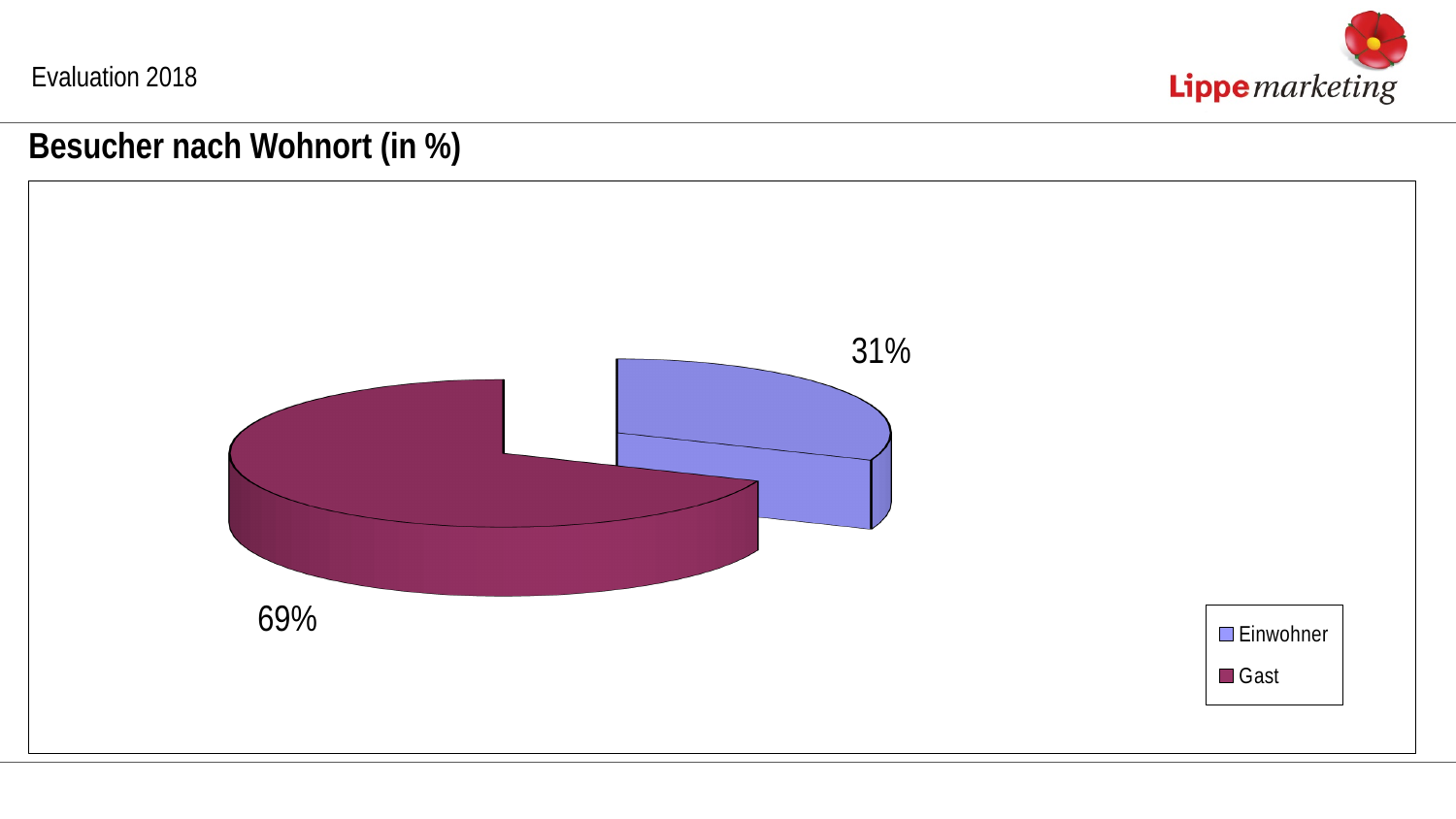
How many categories does the pie chart show? 2 What is the title of the chart? Besucher nach Wohnort (in %) What is the total of the two slices shown? 100% What percentage of visitors are Einwohner? 31% What colour is the Gast slice? Dark red / purple Which category has the largest share of the pie? Gast How many entries does the legend list? 2 What percentage of visitors are Gast? 69% Which is larger, the share for Einwohner or the share for Gast? Gast What kind of chart is shown on the slide? Pie chart What is the difference in percentage points between Gast and Einwohner? 38 Which category has the smallest share of the pie? Einwohner